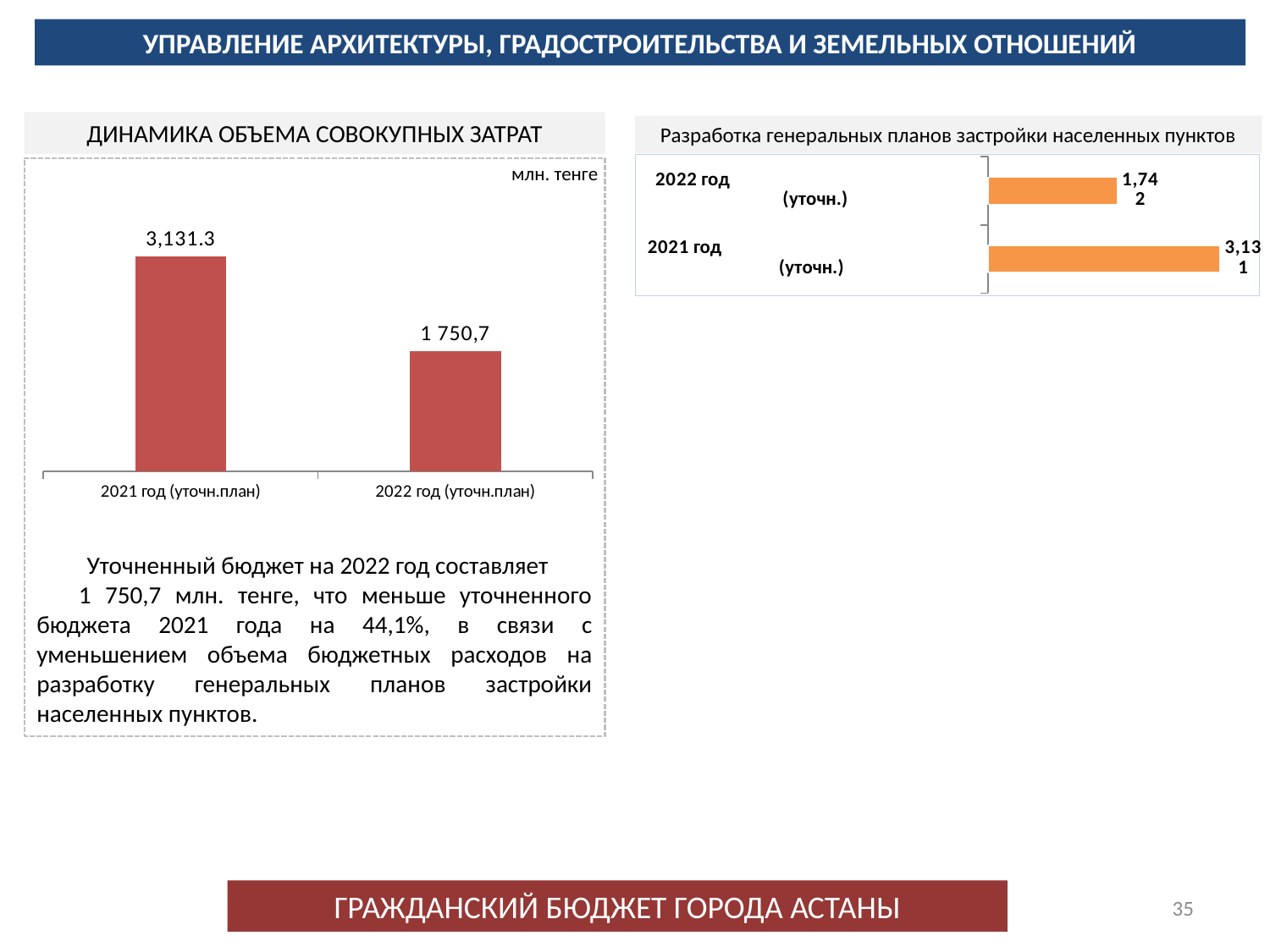
In the chart titled 'ДИНАМИКА ОБЪЕМА СОВОКУПНЫХ ЗАТРАТ', what is the value for 2022 год (уточн.план)? 1 750,7 In the chart titled 'ДИНАМИКА ОБЪЕМА СОВОКУПНЫХ ЗАТРАТ', which category has the highest value? 2021 год (уточн.план) What kind of chart is the one titled 'Разработка генеральных планов застройки населенных пунктов'? Bar chart In the chart titled 'ДИНАМИКА ОБЪЕМА СОВОКУПНЫХ ЗАТРАТ', what is the difference between the 2021 and 2022 values? 1,380.6 What kind of chart is the one titled 'ДИНАМИКА ОБЪЕМА СОВОКУПНЫХ ЗАТРАТ'? Bar chart In the chart titled 'Разработка генеральных планов застройки населенных пунктов', how many bars are plotted? 2 In the chart titled 'ДИНАМИКА ОБЪЕМА СОВОКУПНЫХ ЗАТРАТ', do the values rise or fall from 2021 to 2022? Fall In the chart titled 'Разработка генеральных планов застройки населенных пунктов', which year has the larger value, 2021 год (уточн.) or 2022 год (уточн.)? 2021 год (уточн.) In the chart titled 'ДИНАМИКА ОБЪЕМА СОВОКУПНЫХ ЗАТРАТ', how many bars are plotted? 2 In the chart titled 'ДИНАМИКА ОБЪЕМА СОВОКУПНЫХ ЗАТРАТ', what is the value for 2021 год (уточн.план)? 3,131.3 In the chart titled 'ДИНАМИКА ОБЪЕМА СОВОКУПНЫХ ЗАТРАТ', which category has the lowest value? 2022 год (уточн.план) What unit is shown in the top right corner of the chart titled 'ДИНАМИКА ОБЪЕМА СОВОКУПНЫХ ЗАТРАТ'? млн. тенге